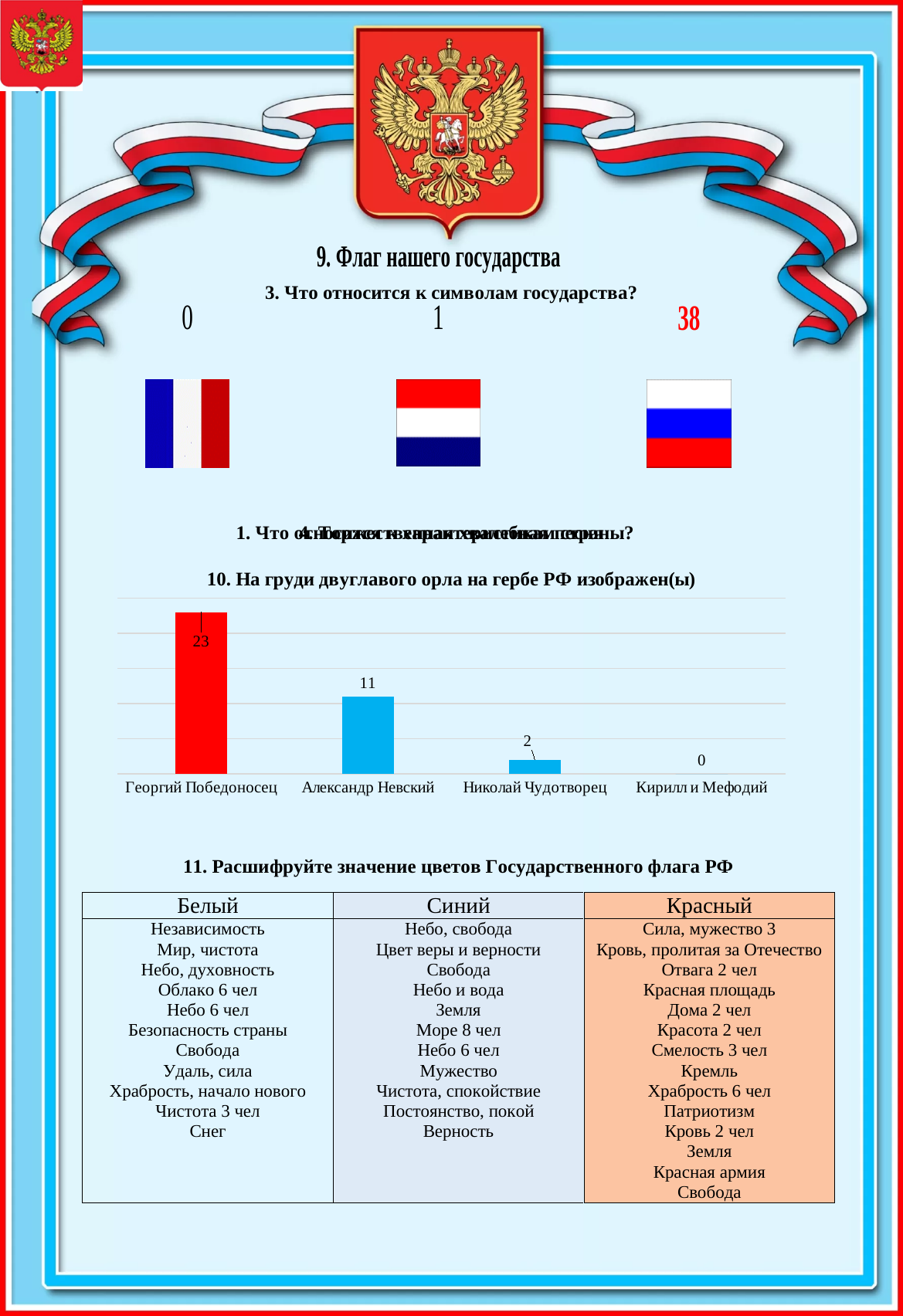
In the bar chart, what is the value for Кирилл и Мефодий? 0 In the bar chart, which is larger: the value for Александр Невский or the value for Николай Чудотворец? Александр Невский In the bar chart, what is the value for Георгий Победоносец? 23 In the bar chart, what is the difference between the values for Георгий Победоносец and Александр Невский? 12 In the bar chart, what is the value for Александр Невский? 11 What type of chart is shown under the heading "10. На груди двуглавого орла на гербе РФ изображен(ы)"? bar chart In the bar chart, what is the value for Николай Чудотворец? 2 Do the values in the bar chart rise or fall from left to right? fall In the bar chart, what is the difference between the values for Александр Невский and Николай Чудотворец? 9 Which category has the lowest value in the bar chart? Кирилл и Мефодий Which category has the highest value in the bar chart? Георгий Победоносец How many categories are shown in the bar chart? 4